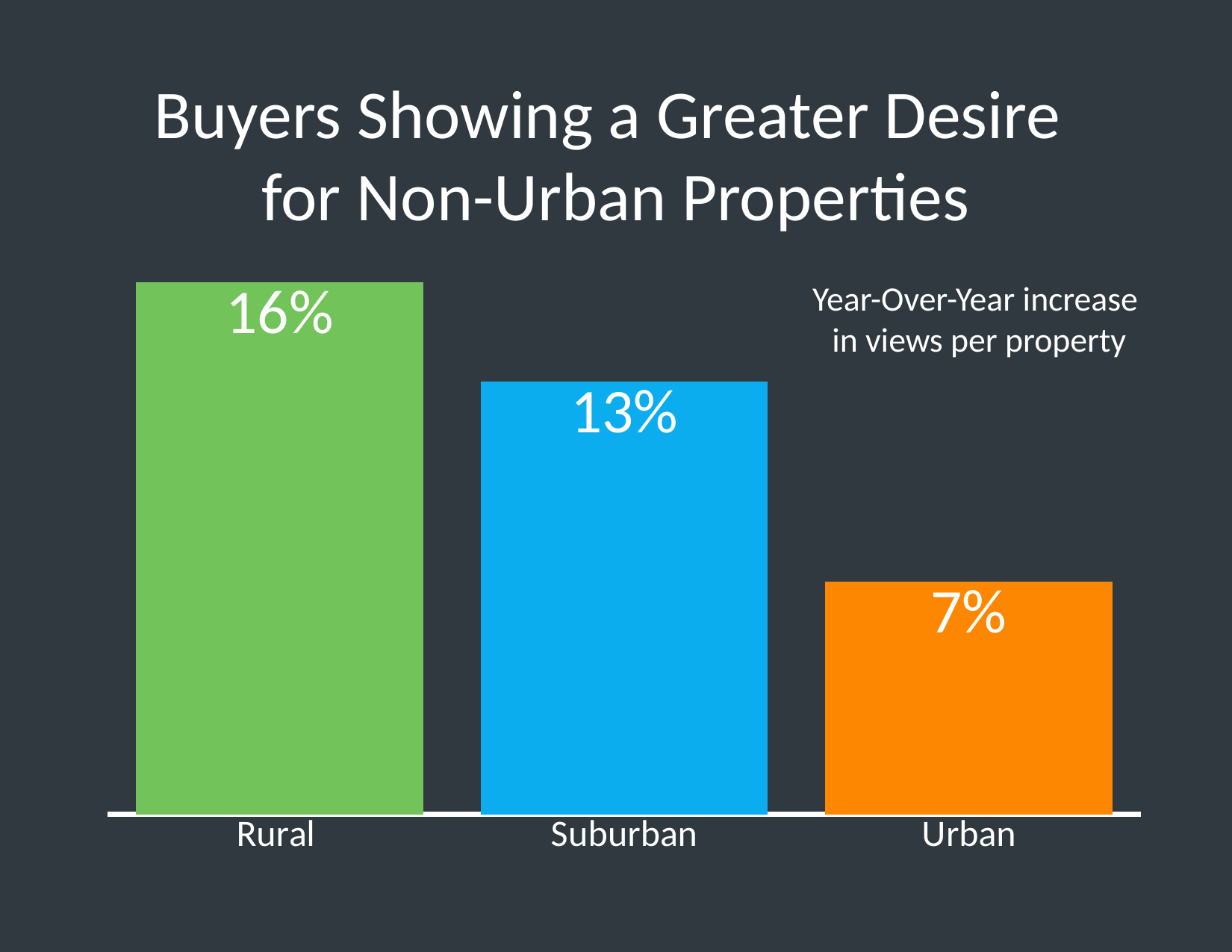
Which category has the highest year-over-year increase in views per property? Rural What is the year-over-year increase in views per property for Rural? 16% Do the values rise or fall moving from Rural to Urban along the x axis? Fall Which category has the lowest year-over-year increase in views per property? Urban What is the year-over-year increase in views per property for Urban? 7% What is the year-over-year increase in views per property for Suburban? 13% Which is larger, the value for Suburban or the value for Urban? Suburban What colour is the Urban bar? Orange How many categories are shown in the chart? 3 What kind of chart is shown on the slide? Bar chart What is the difference between the Rural and Urban values? 9% What is the difference between the Rural and Suburban values? 3%